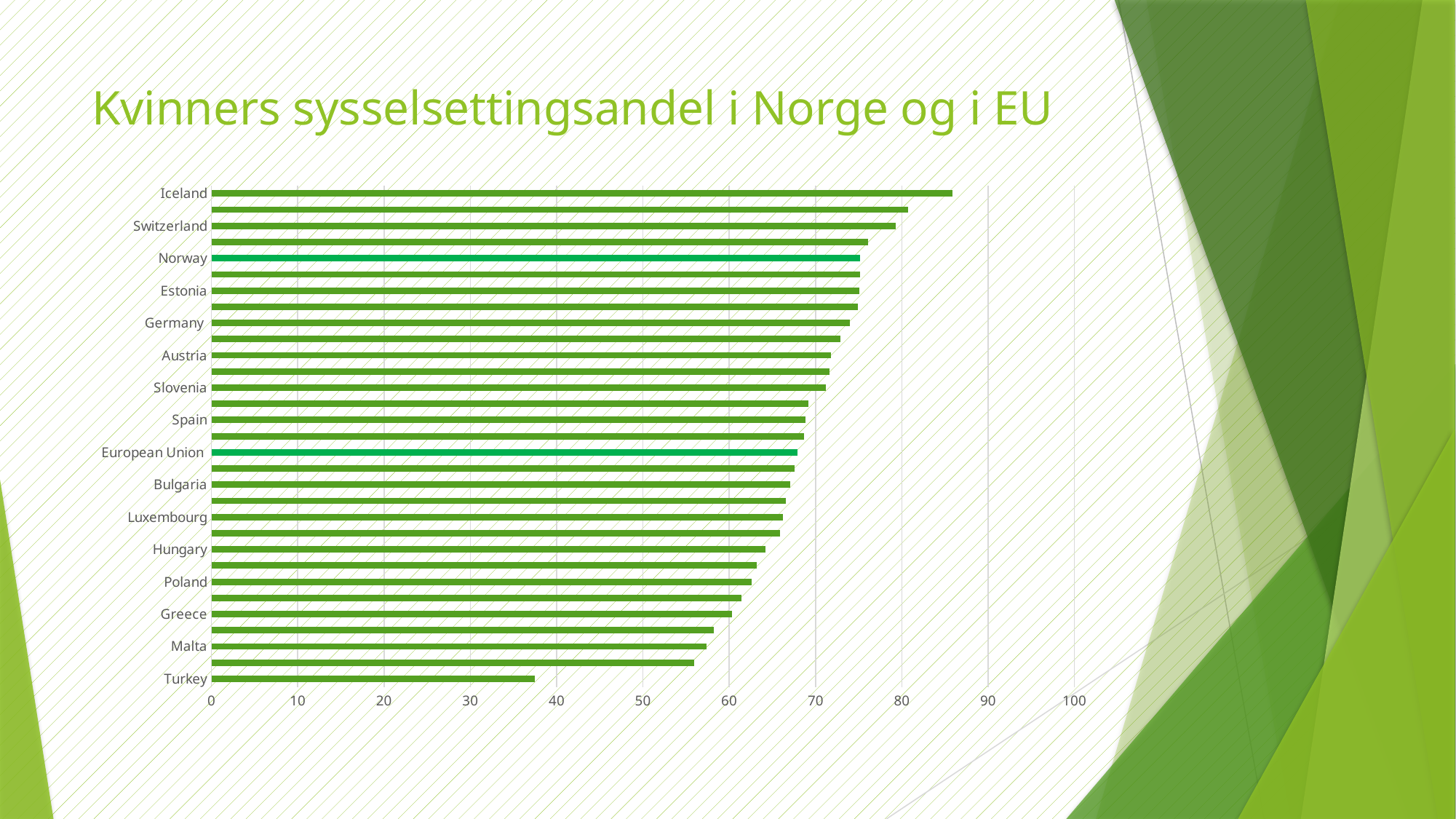
Which two bars are drawn in a different, darker green colour than the rest? Norway and European Union Which country has the highest value in the chart? Iceland What kind of chart is shown on the slide? bar chart Which has the larger value, Norway or European Union? Norway Is the value for European Union greater or less than 70? less Is the value for Turkey greater or less than 40? less Is the value for Norway greater or less than 70? greater What is the title of the chart? Kvinners sysselsettingsandel i Norge og i EU Which country has the lowest value in the chart? Turkey Which has the larger value, Malta or Germany? Germany